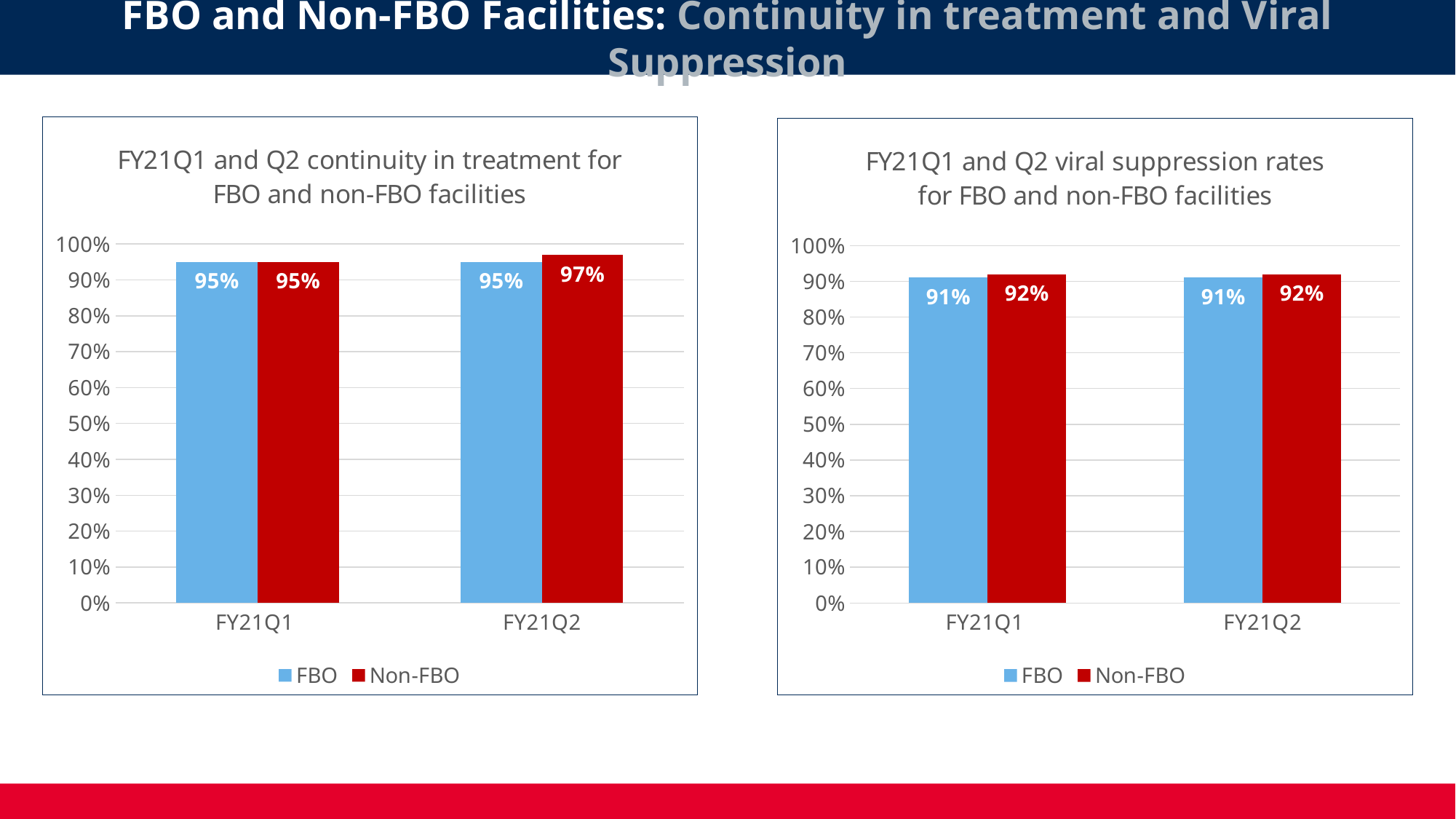
In the left chart (continuity in treatment), what is the difference between the Non-FBO and FBO values in FY21Q2? 2% In the left chart (continuity in treatment), what is the value for FBO in FY21Q1? 95% In the right chart (viral suppression rates), what is the value for Non-FBO in FY21Q1? 92% In the left chart (continuity in treatment), is the Non-FBO value in FY21Q2 greater or less than 90%? greater In the right chart (viral suppression rates), what is the value for FBO in FY21Q2? 91% In the left chart (continuity in treatment), which colour represents Non-FBO? Red In the left chart (continuity in treatment), which bar has the highest value? Non-FBO in FY21Q2 In the right chart (viral suppression rates), what is the difference between the Non-FBO and FBO values in FY21Q1? 1% How many series does the legend of the right chart (viral suppression rates) list? 2 What kind of chart is the right chart (viral suppression rates)? Bar chart How many quarters are shown on the x axis of the left chart (continuity in treatment)? 2 In the left chart (continuity in treatment), what is the value for Non-FBO in FY21Q2? 97%